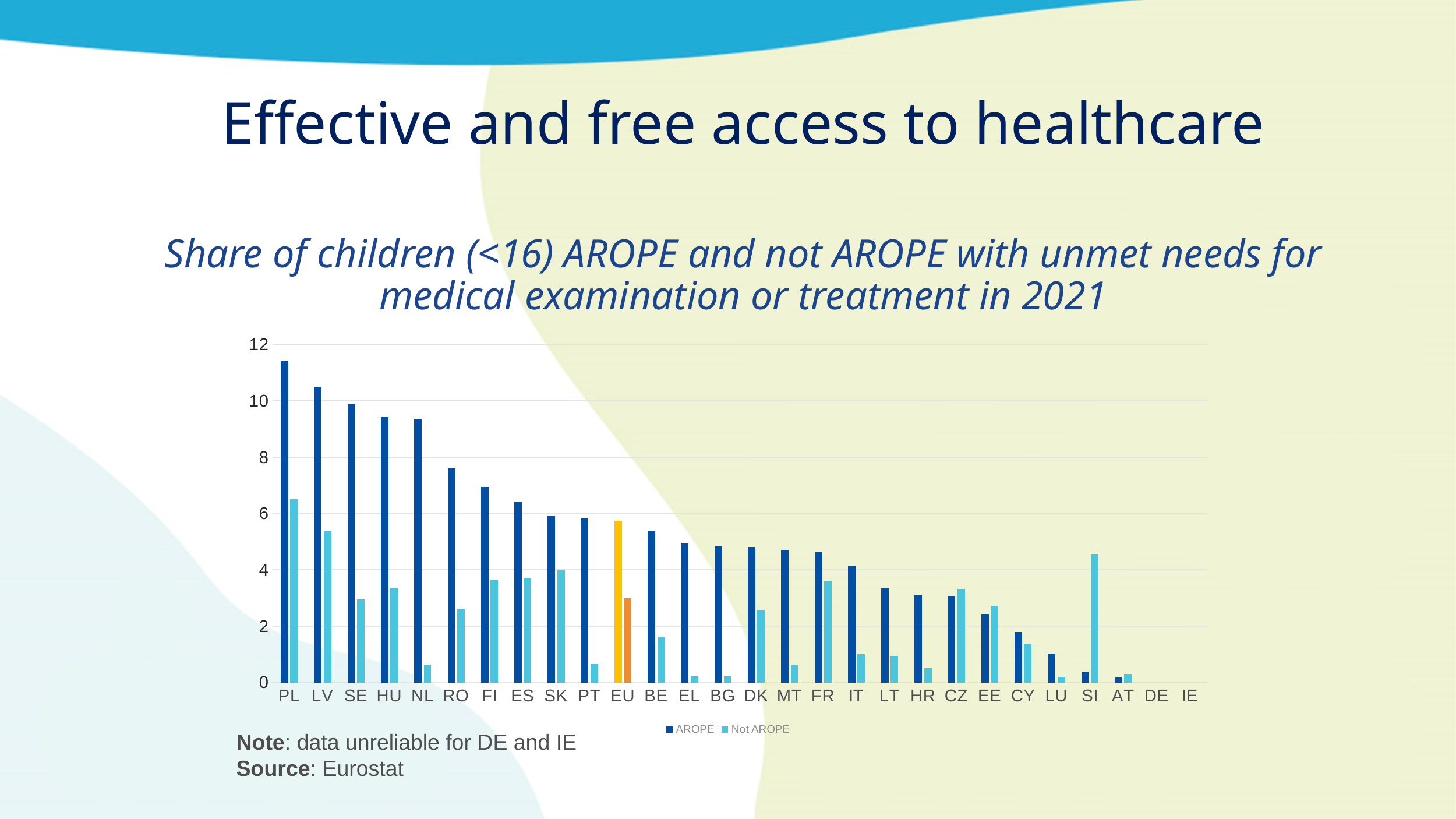
According to the note, for which countries is the data unreliable? DE and IE Which category has the highest Not AROPE value? PL Is the AROPE value for PL greater or less than 10? greater What kind of chart is shown on the slide? bar chart Do the AROPE values rise or fall moving from left to right along the x axis? fall How many series does the legend list? 2 Which category has the highest AROPE value? PL Is the Not AROPE value for NL greater or less than 2? less Is the AROPE value for EU greater or less than 6? less For SI, which is larger: the AROPE value or the Not AROPE value? Not AROPE How many countries/categories are shown on the x axis? 28